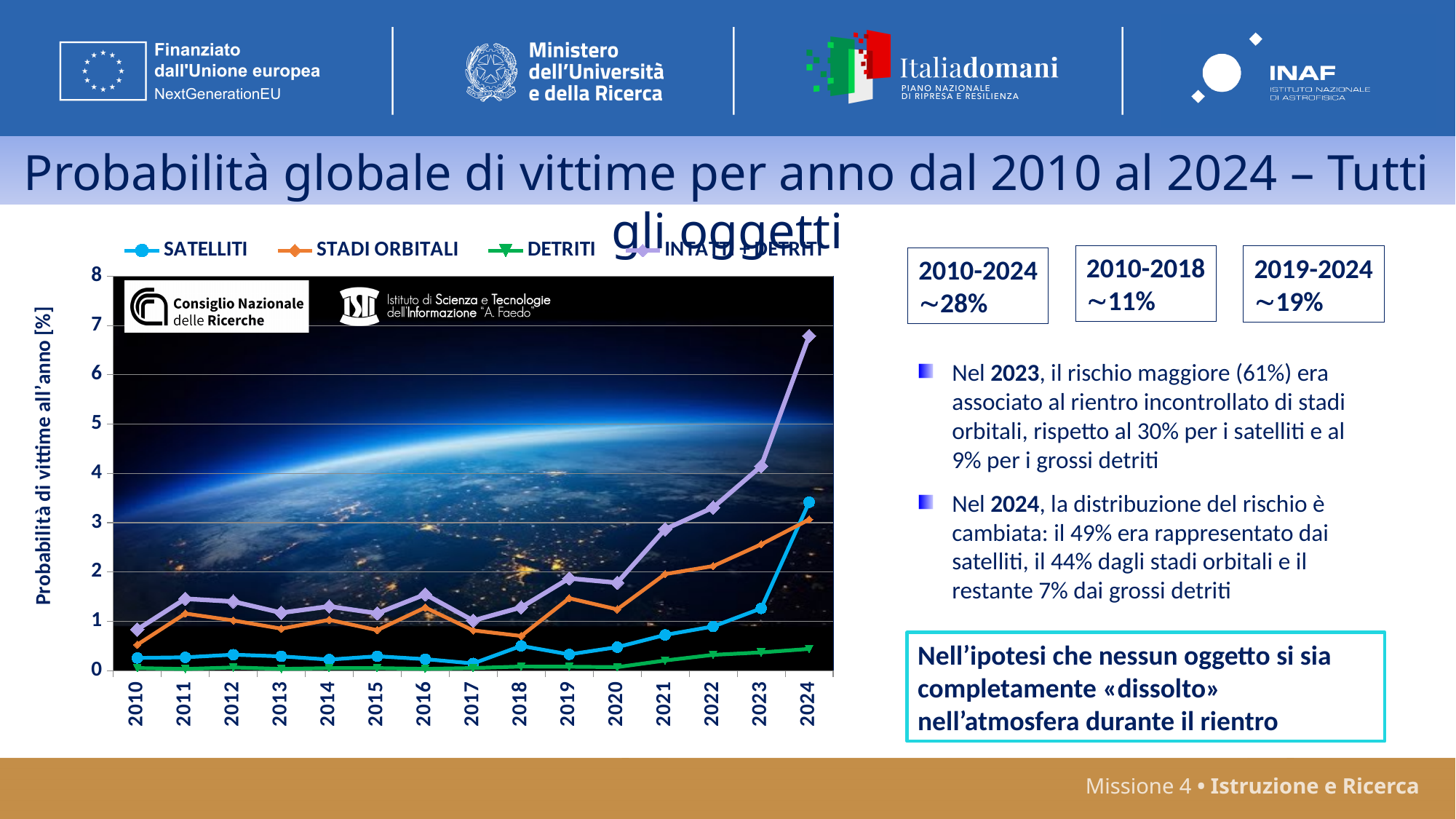
Is the value for SATELLITI in 2024 greater or less than 3? greater In 2023, which is higher: SATELLITI or STADI ORBITALI? STADI ORBITALI How many series does the chart's legend list? 4 What is the label of the chart's y axis? Probabilità di vittime all'anno [%] Is the value for DETRITI in 2024 greater or less than 1? less Which of the labelled series has the lowest value in 2024? DETRITI What kind of chart is shown on the slide? line chart Is the value for STADI ORBITALI in 2024 greater or less than 2? greater How many years are plotted along the x axis of the chart? 15 Does the SATELLITI series rise or fall from 2020 to 2024? rise In which year does the SATELLITI series reach its highest value? 2024